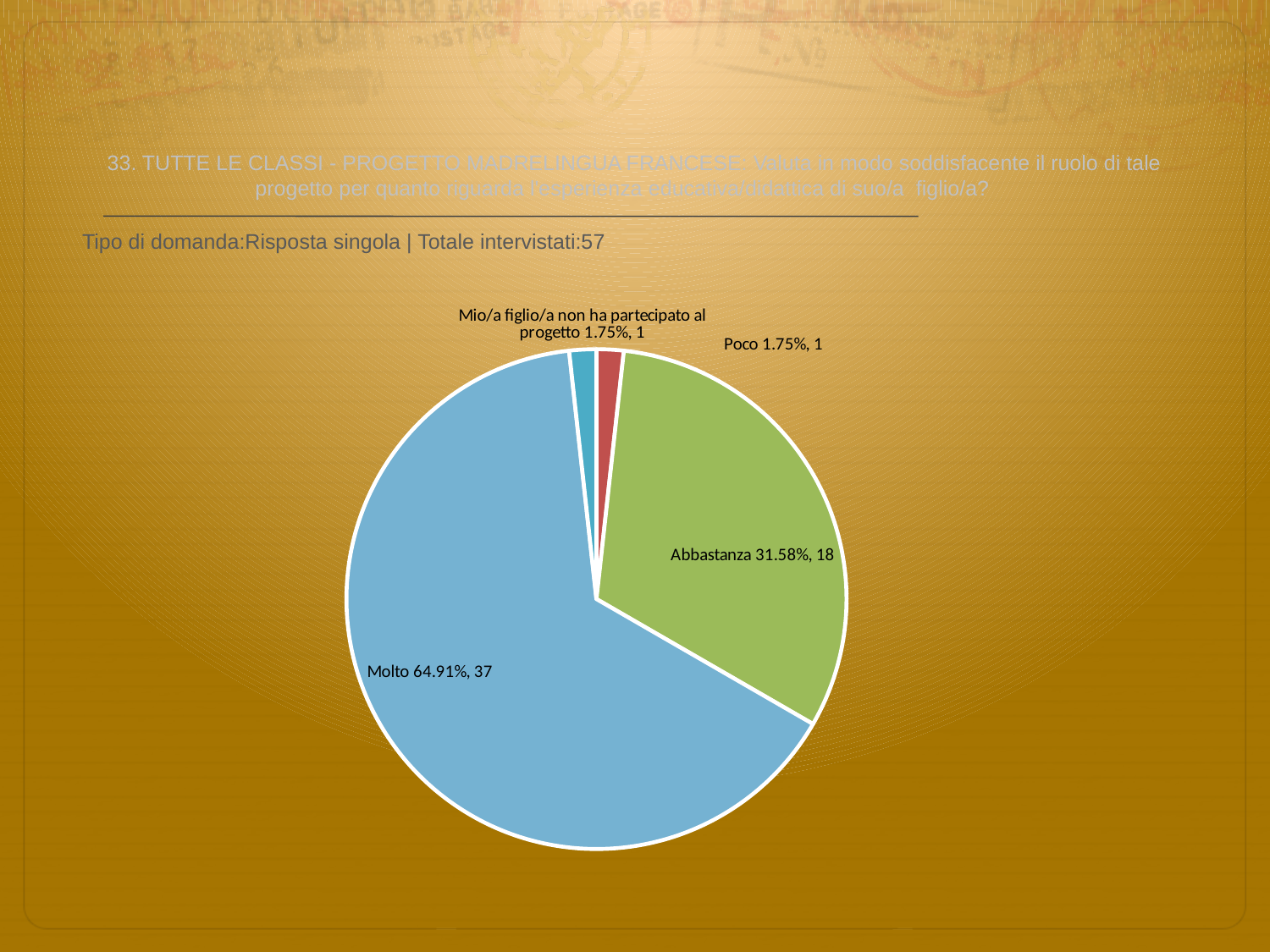
Which category has the largest slice of the pie? Molto What is the count for the 'Molto' slice? 37 What is the count for the 'Poco' slice? 1 What percentage is shown for the 'Abbastanza' slice? 31.58% What share of the pie does the 'Molto' slice represent? 64.91% How many slices does the pie chart have? 4 What colour is the 'Abbastanza' slice? green What is the difference in count between 'Molto' and 'Abbastanza'? 19 What percentage is shown for 'Mio/a figlio/a non ha partecipato al progetto'? 1.75% Which is larger, the 'Abbastanza' slice or the 'Poco' slice? Abbastanza What is the total number of respondents (Totale intervistati) stated on the slide? 57 What kind of chart is shown on the slide? pie chart